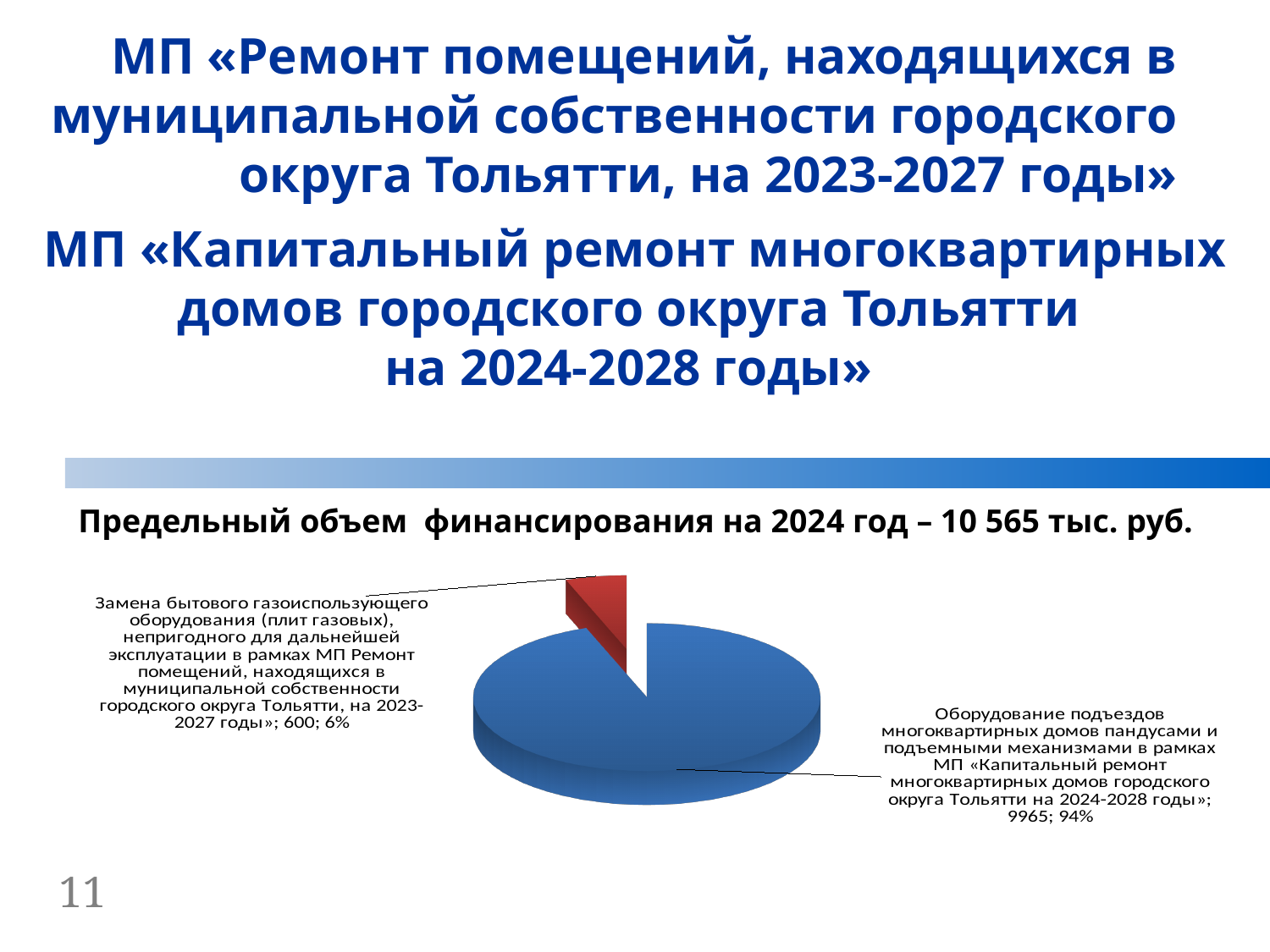
What is the value for «Оборудование подъездов многоквартирных домов пандусами и подъемными механизмами» in the pie chart? 9965 Which slice of the pie chart is the largest? Оборудование подъездов многоквартирных домов пандусами и подъемными механизмами What colour is the slice for «Замена бытового газоиспользующего оборудования (плит газовых)»? Red What is the difference between the values for «Оборудование подъездов многоквартирных домов пандусами» and «Замена бытового газоиспользующего оборудования»? 9365 What share of the pie does «Оборудование подъездов многоквартирных домов пандусами и подъемными механизмами» represent? 94% Which slice of the pie chart is the smallest? Замена бытового газоиспользующего оборудования (плит газовых) What is the total of the two values shown in the pie chart? 10 565 Which is larger: the value for «Замена бытового газоиспользующего оборудования» or for «Оборудование подъездов многоквартирных домов пандусами»? Оборудование подъездов многоквартирных домов пандусами What kind of chart is shown on the slide? Pie chart How many slices does the pie chart have? 2 What share of the pie does «Замена бытового газоиспользующего оборудования (плит газовых)» represent? 6% What is the value for «Замена бытового газоиспользующего оборудования (плит газовых)» in the pie chart? 600